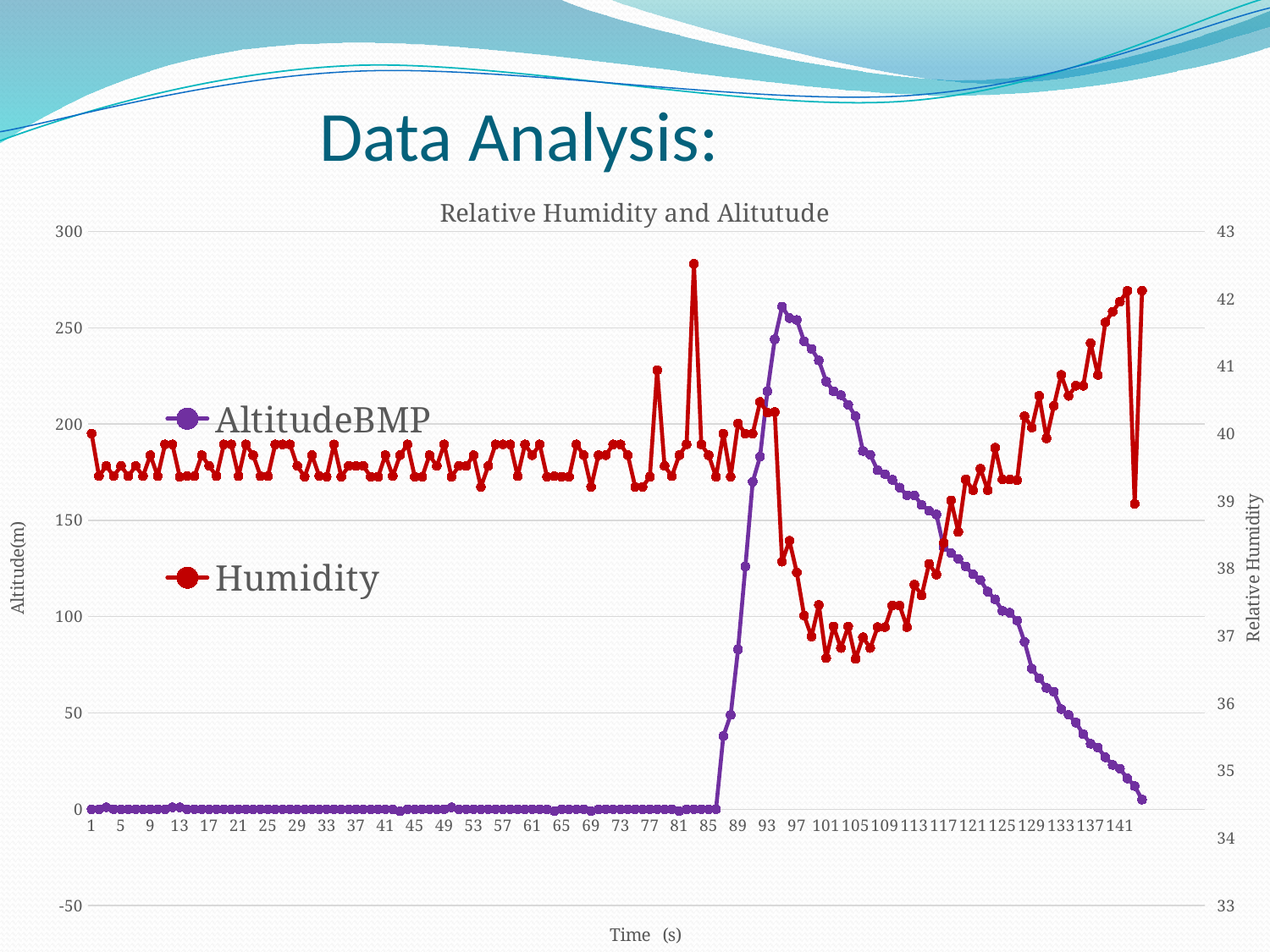
Does the AltitudeBMP series rise or fall between time 97 and time 141? fall How many series does the legend list? 2 Is the peak AltitudeBMP value (around time 95) greater or less than 200? greater Which series is drawn in red? Humidity Is the AltitudeBMP value at time 141 greater or less than 50? less Is the AltitudeBMP value at time 1 greater or less than 50? less What is the label of the horizontal axis? Time (s) What kind of chart is shown on the slide? Line chart Does the AltitudeBMP series rise or fall between time 85 and time 95? rise What is the title of the chart? Relative Humidity and Alitutude